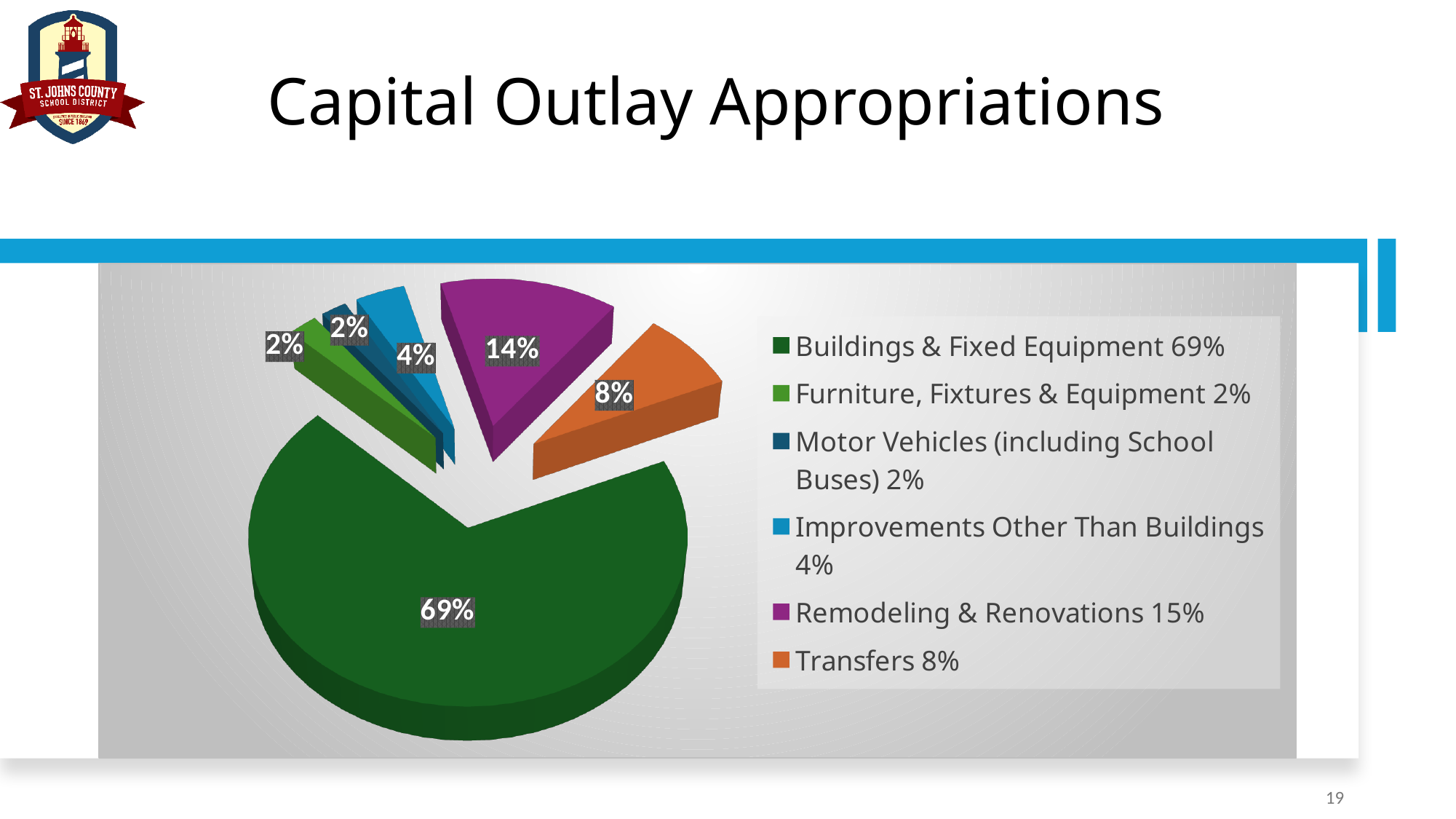
How many categories does the legend of the pie chart list? 6 Which is larger, the share for Transfers or the share for Improvements Other Than Buildings? Transfers What is the difference between the share for Buildings & Fixed Equipment and the share for Transfers? 61% What share of the pie is Transfers? 8% What share of the pie is Improvements Other Than Buildings? 4% What share of the pie is Buildings & Fixed Equipment? 69% What is the title of the slide's chart? Capital Outlay Appropriations Which category has the largest share of the pie? Buildings & Fixed Equipment What kind of chart is shown on the slide? pie chart What colour is the slice for Transfers? orange